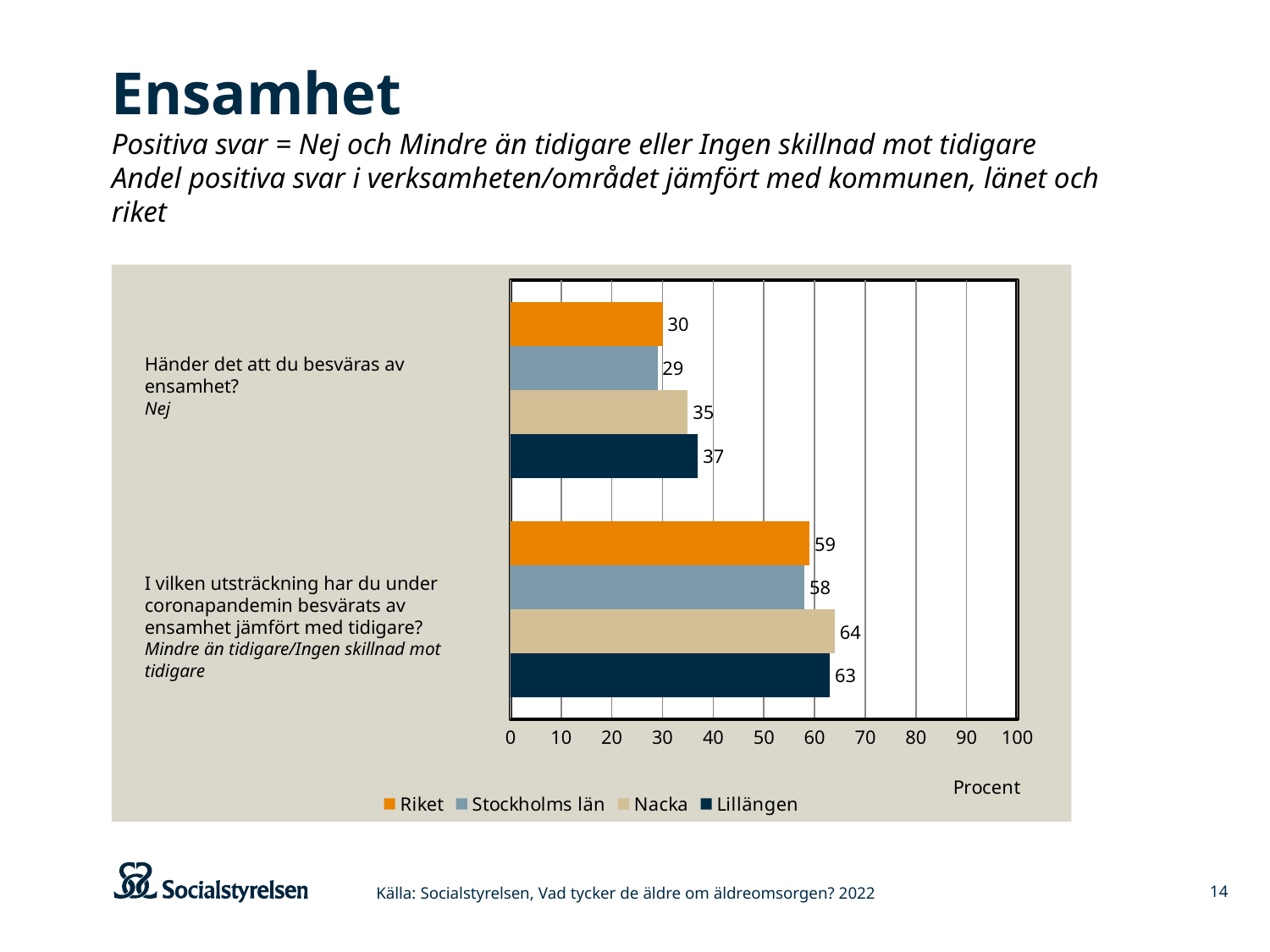
What is the value for Nacka on the question "Händer det att du besväras av ensamhet?"? 35 Which series has the lowest value on the question "I vilken utsträckning har du under coronapandemin besvärats av ensamhet jämfört med tidigare?"? Stockholms län What is the value for Stockholms län on the question "I vilken utsträckning har du under coronapandemin besvärats av ensamhet jämfört med tidigare?"? 58 What is the difference between the Nacka and Riket values on the question "I vilken utsträckning har du under coronapandemin besvärats av ensamhet jämfört med tidigare?"? 5 What kind of chart is shown on the slide? Bar chart How many series does the legend list? 4 What is the value for Lillängen on the question "Händer det att du besväras av ensamhet?"? 37 Which is larger on the question "Händer det att du besväras av ensamhet?": the value for Nacka or the value for Riket? Nacka Is the value for Lillängen on the question "I vilken utsträckning har du under coronapandemin besvärats av ensamhet jämfört med tidigare?" greater or less than 50? greater What is the value for Riket on the question "I vilken utsträckning har du under coronapandemin besvärats av ensamhet jämfört med tidigare?"? 59 Which series has the highest value on the question "Händer det att du besväras av ensamhet?"? Lillängen What unit is shown on the horizontal axis of the chart? Procent